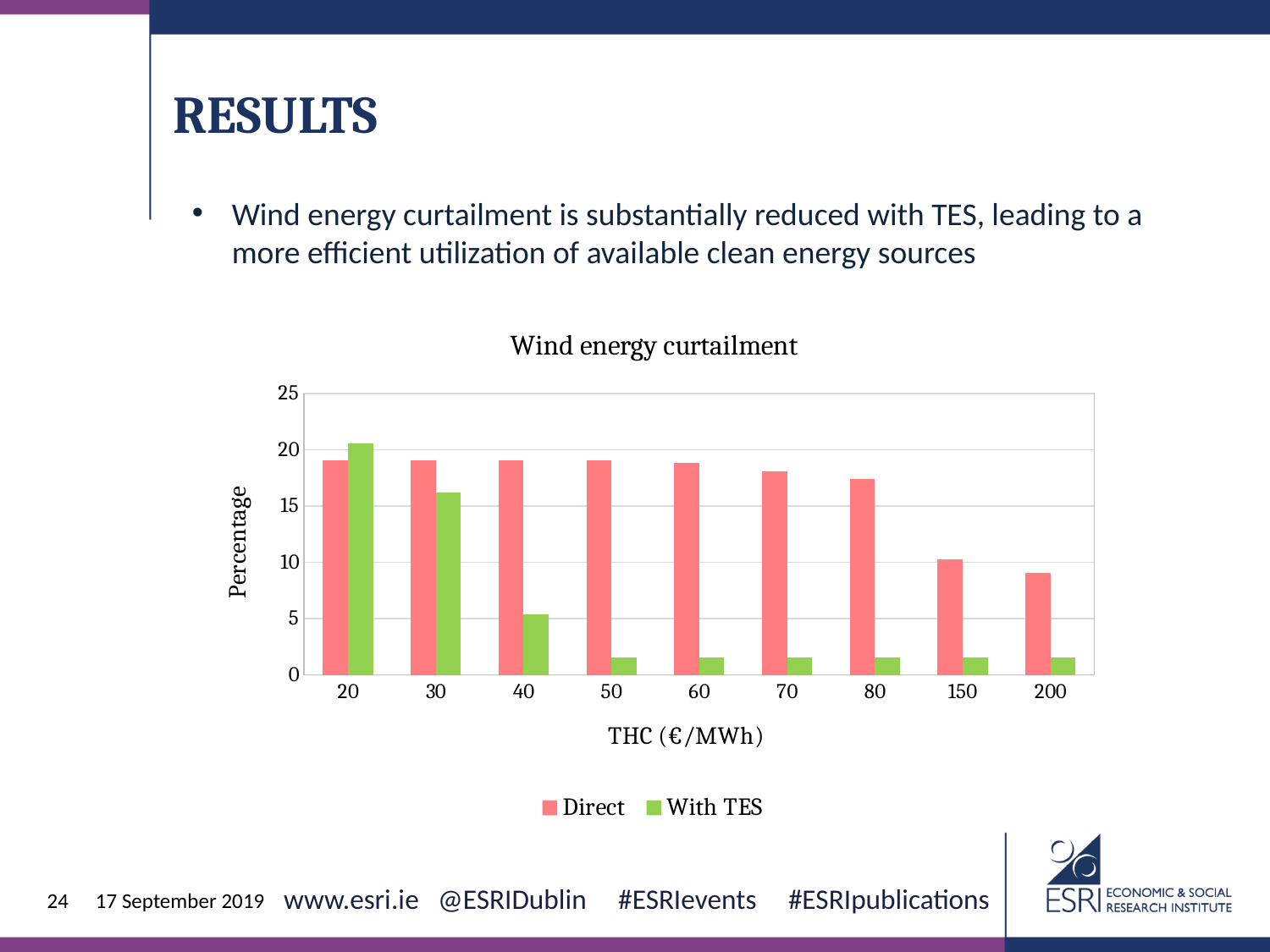
How many series does the legend list? 2 At THC 20 €/MWh, which is larger, Direct or With TES? With TES Which THC value has the highest With TES curtailment? 20 At THC 40 €/MWh, which is larger, Direct or With TES? Direct How many THC categories are shown on the x axis? 9 Is the With TES value at THC 30 greater or less than 15? greater What is the title of the chart? Wind energy curtailment Is the Direct value at THC 200 greater or less than 10? less What kind of chart is shown on the slide? bar chart Is the With TES value at THC 50 greater or less than 5? less Which THC value has the lowest Direct curtailment? 200 Do the Direct values rise or fall as THC increases along the x axis? fall